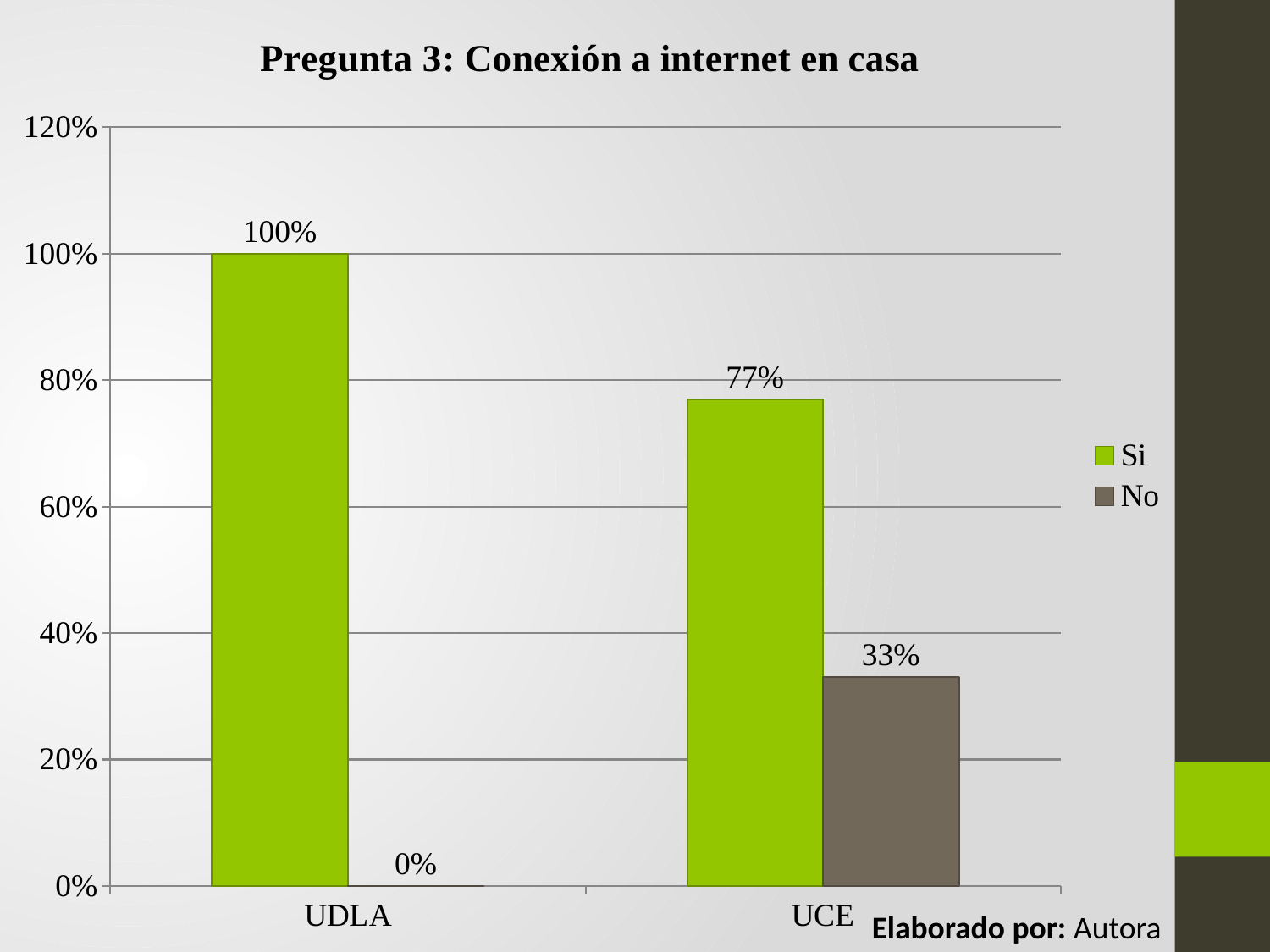
What kind of chart is shown? Bar chart What is the value for No at UDLA? 0% How many categories are shown on the x axis? 2 What is the value for No at UCE? 33% Which category has the highest value for Si? UDLA Which is larger at UCE, Si or No? Si What is the difference between the Si values for UDLA and UCE? 23% How many series does the legend list? 2 Which category has the lowest value for No? UDLA What is the value for Si at UDLA? 100% What is the difference between Si and No at UCE? 44% What is the value for Si at UCE? 77%